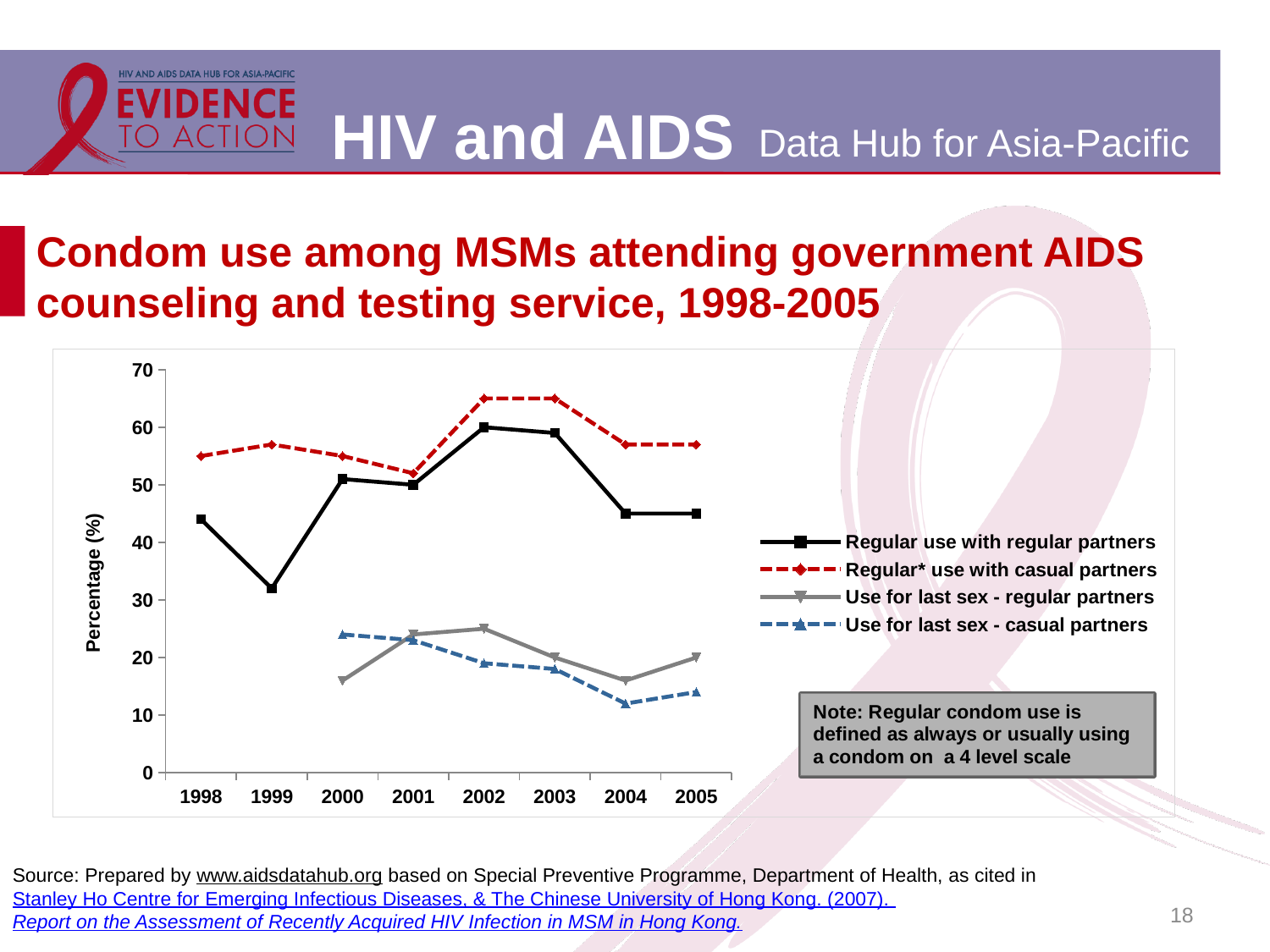
What kind of chart is shown on the slide? line chart Is the value for 'Regular use with regular partners' in 1999 greater or less than 40? less Does 'Use for last sex - casual partners' rise or fall from 2001 to 2004? fall Is the value for 'Regular* use with casual partners' in 2002 greater or less than 60? greater Is the value for 'Regular use with regular partners' in 1998 greater or less than 40? greater How many series does the legend list? 4 In which year is 'Regular use with regular partners' at its lowest? 1999 In which year is 'Use for last sex - casual partners' at its lowest? 2004 How many years are shown on the x axis? 8 In 1998, which is larger: 'Regular use with regular partners' or 'Regular* use with casual partners'? Regular* use with casual partners What is the label on the y axis? Percentage (%)